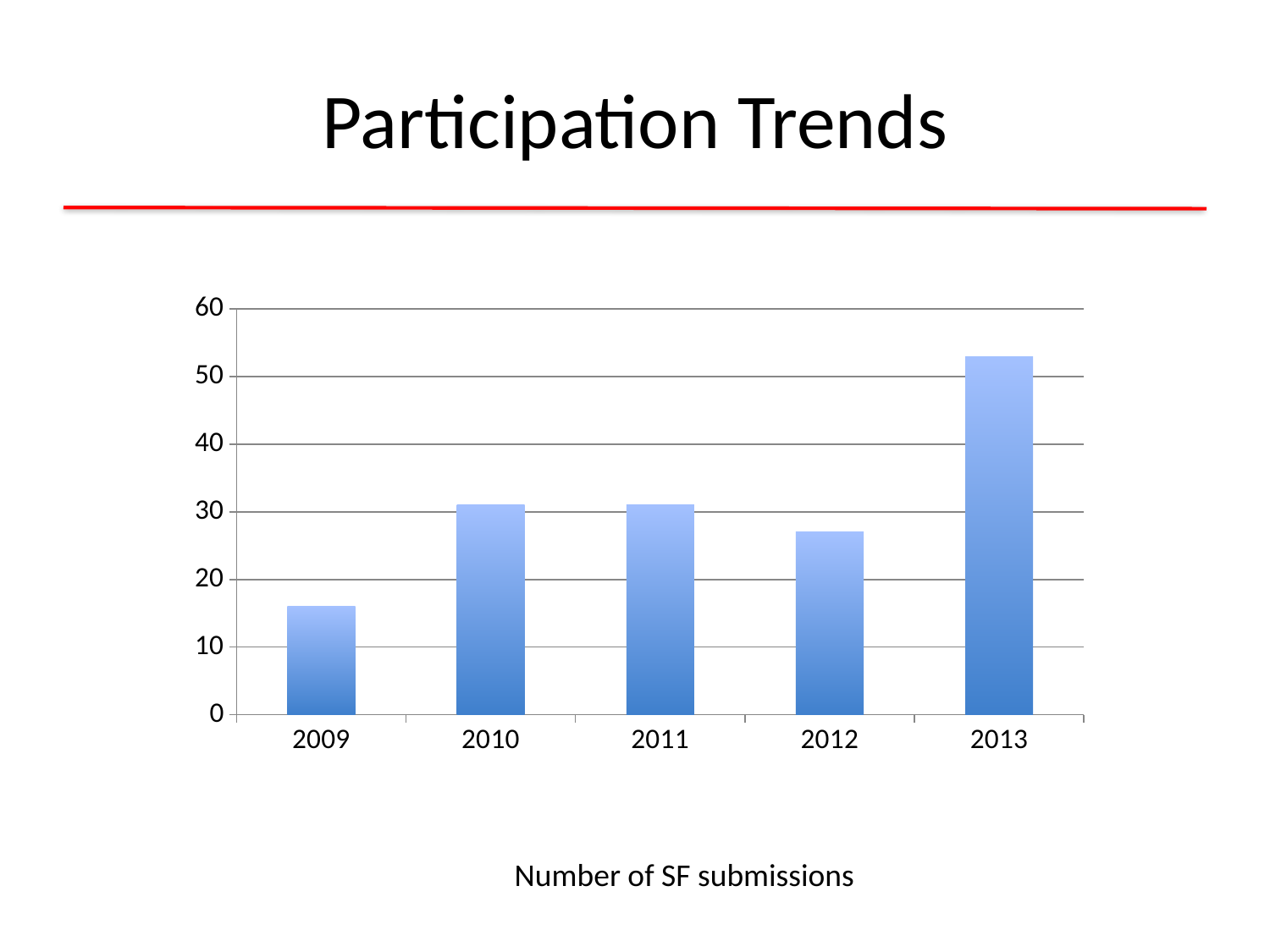
How many years are shown on the x axis of the chart? 5 What kind of chart is shown on the slide? bar chart Which year has the lowest number of SF submissions? 2009 Is the value for 2013 greater or less than 50? greater What is the title of the slide containing the chart? Participation Trends Which year has the larger value, 2012 or 2013? 2013 Which year has the larger value, 2009 or 2012? 2012 Which year has the highest number of SF submissions? 2013 Is the value for 2012 greater or less than 30? less Is the value for 2009 greater or less than 20? less Does the value rise or fall from 2012 to 2013? rise